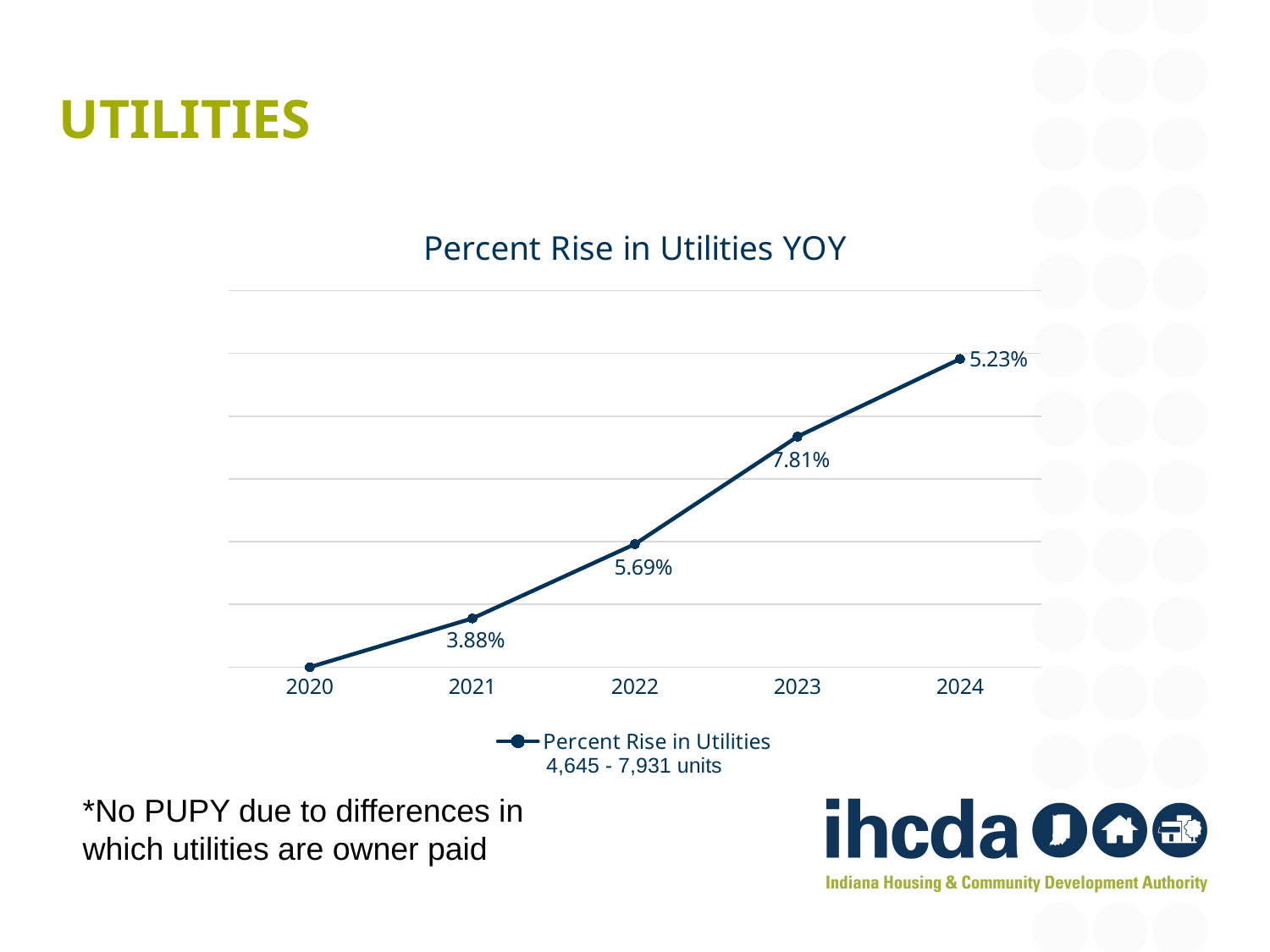
How many years are plotted on the x axis? 5 What kind of chart is shown on the slide? line chart How many series does the legend list? 1 What is the data label shown for 2023? 7.81% What is the data label shown for 2021? 3.88% What is the difference between the data labels for 2023 and 2022? 2.12% What is the difference between the data labels for 2022 and 2021? 1.81% Does the plotted line rise or fall from 2020 to 2024? rise What is the title of the chart? Percent Rise in Utilities YOY Which data label is larger, the one for 2023 or the one for 2024? 2023 What is the data label shown for 2022? 5.69% What is the data label shown for 2024? 5.23%